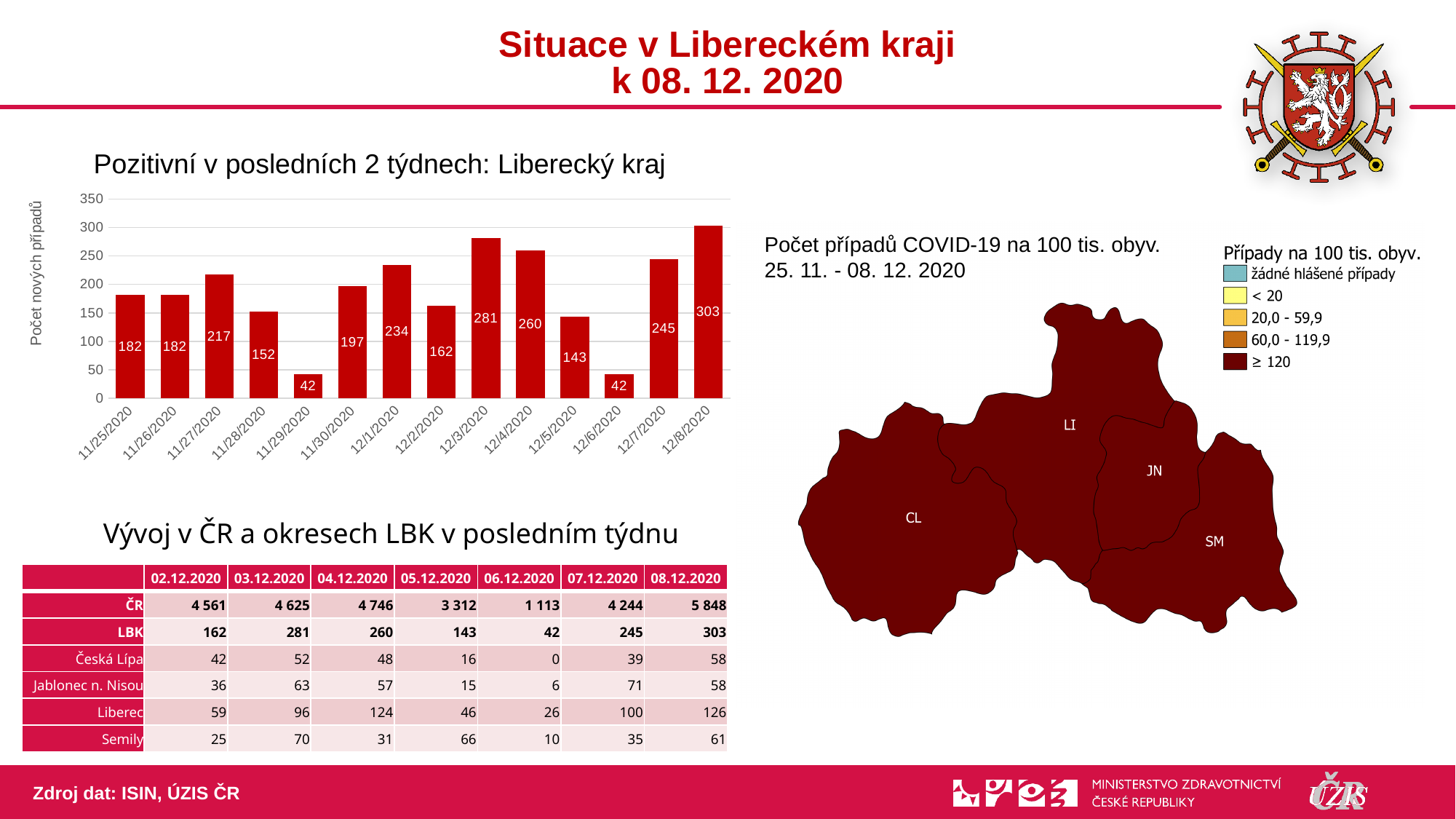
What is the value for 12/7/2020 in the bar chart? 245 What kind of chart is shown on the slide? bar chart Is the value for 11/27/2020 greater or less than 200? greater How many dates are shown on the x axis of the bar chart? 14 What is the difference between the values for 12/1/2020 and 11/30/2020? 37 Which date has the highest value in the bar chart? 12/8/2020 What is the difference between the values for 12/8/2020 and 12/5/2020? 160 What is the lowest value shown in the bar chart? 42 What is the value for 12/3/2020 in the bar chart? 281 What is the title of the bar chart? Pozitivní v posledních 2 týdnech: Liberecký kraj Which is larger in the bar chart, the value for 12/4/2020 or the value for 12/2/2020? 12/4/2020 What is the value for 11/28/2020 in the bar chart? 152